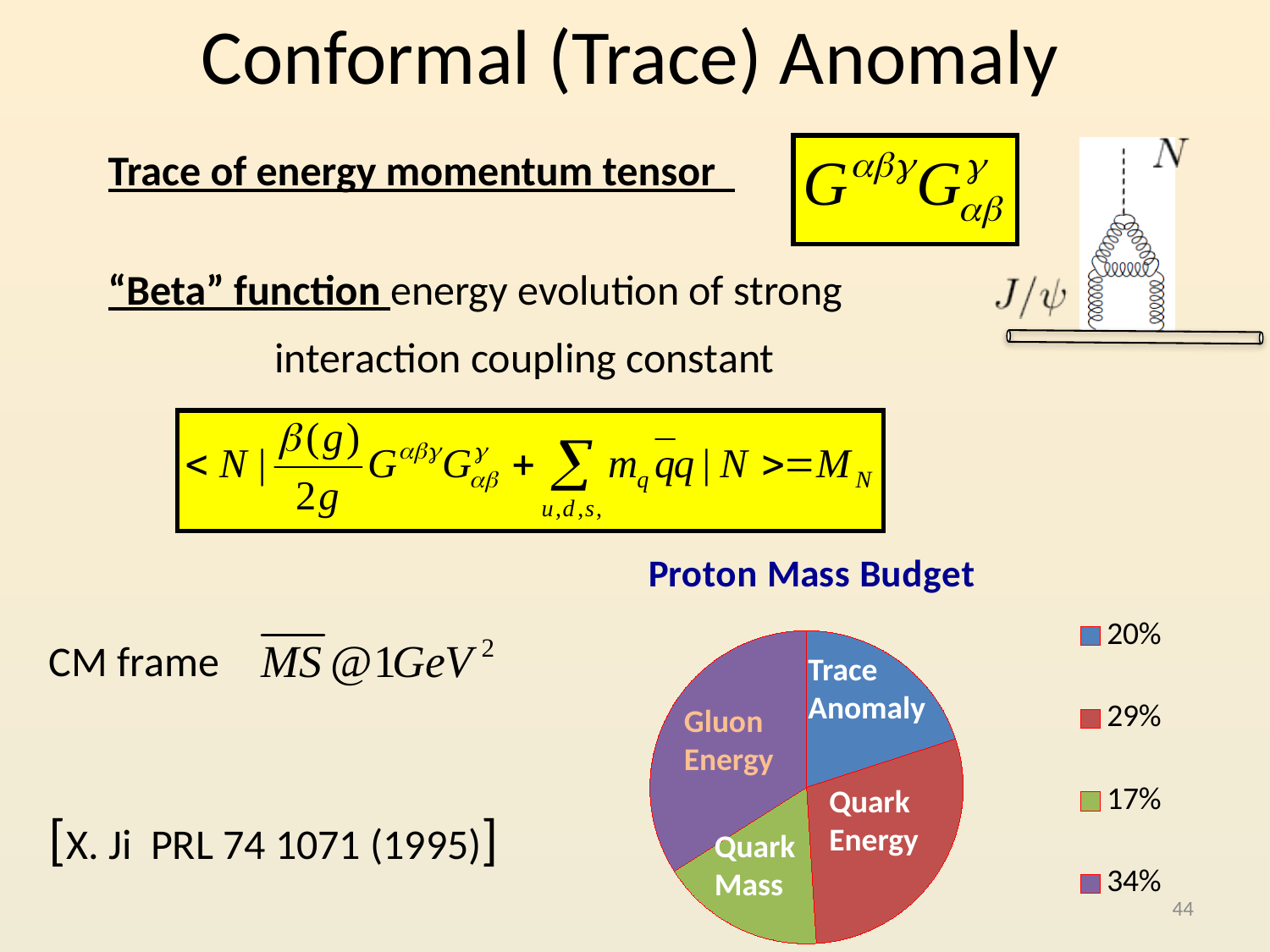
What share of the proton mass budget is attributed to Quark Mass? 17% In the Proton Mass Budget chart, what is the difference between the Gluon Energy share and the Quark Mass share? 17% What is the title of the pie chart? Proton Mass Budget What share of the proton mass budget is attributed to Quark Energy? 29% Which slice of the Proton Mass Budget pie is the smallest? Quark Mass What share of the proton mass budget is attributed to Trace Anomaly? 20% In the Proton Mass Budget chart, which is larger: Quark Energy or Trace Anomaly? Quark Energy Which slice of the Proton Mass Budget pie is the largest? Gluon Energy What kind of chart is the Proton Mass Budget chart? pie chart How many slices does the Proton Mass Budget pie chart have? 4 How many entries does the legend of the Proton Mass Budget chart list? 4